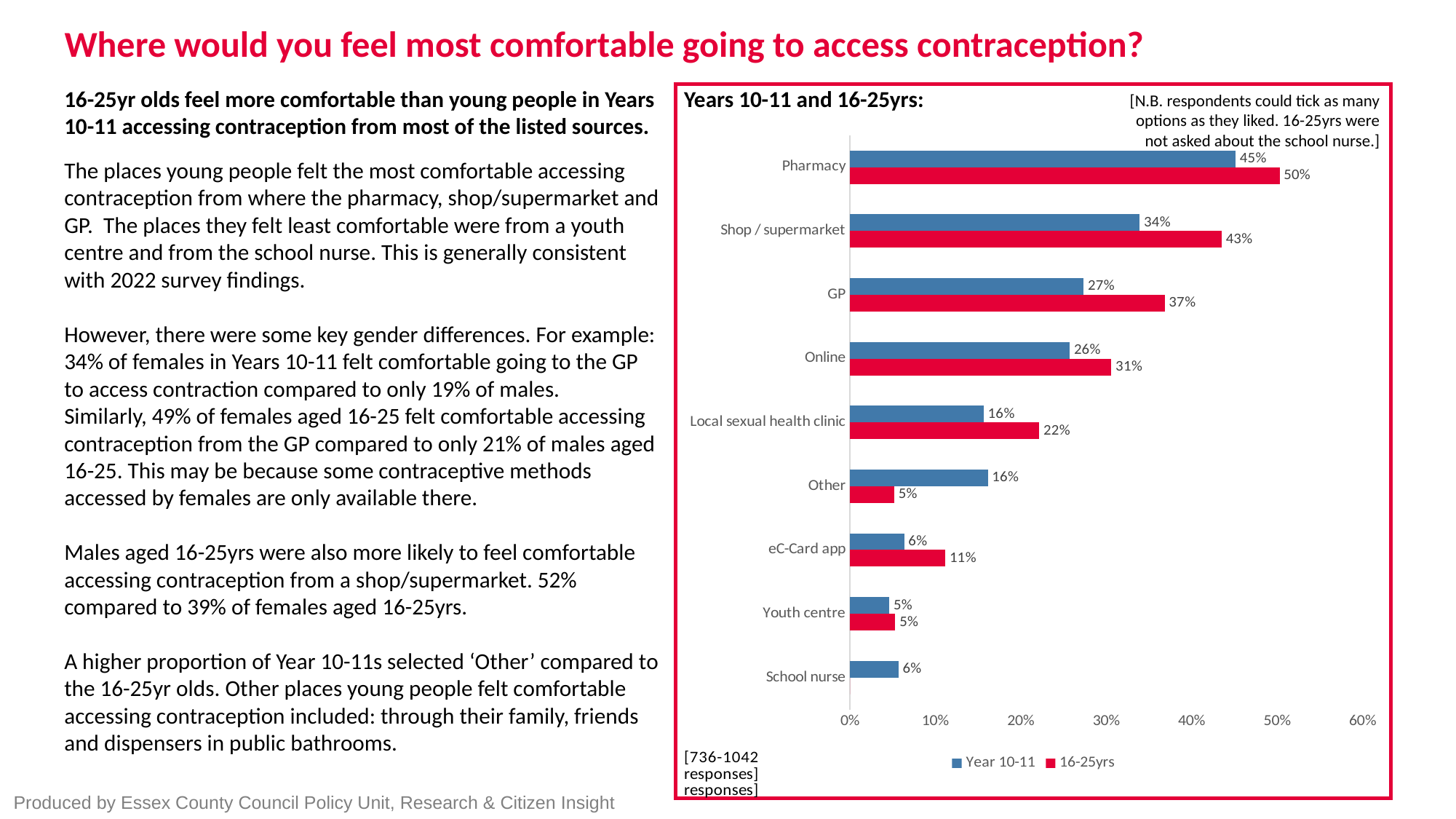
How many categories are shown on the chart? 9 What colour are the bars for the 16-25yrs series? Red Which category has the highest value for the 16-25yrs series? Pharmacy What is the value for 16-25yrs for the GP category? 37% What kind of chart is shown on the slide? Bar chart How many series does the legend list? 2 Which series has the larger value for the Other category, Year 10-11 or 16-25yrs? Year 10-11 What percentage of Year 10-11 respondents said they would feel most comfortable accessing contraception from a pharmacy? 45% What percentage of 16-25yrs respondents selected Shop / supermarket? 43% What is the difference between the 16-25yrs and Year 10-11 values for Shop / supermarket? 9% Which category has a value for only one of the two series? School nurse